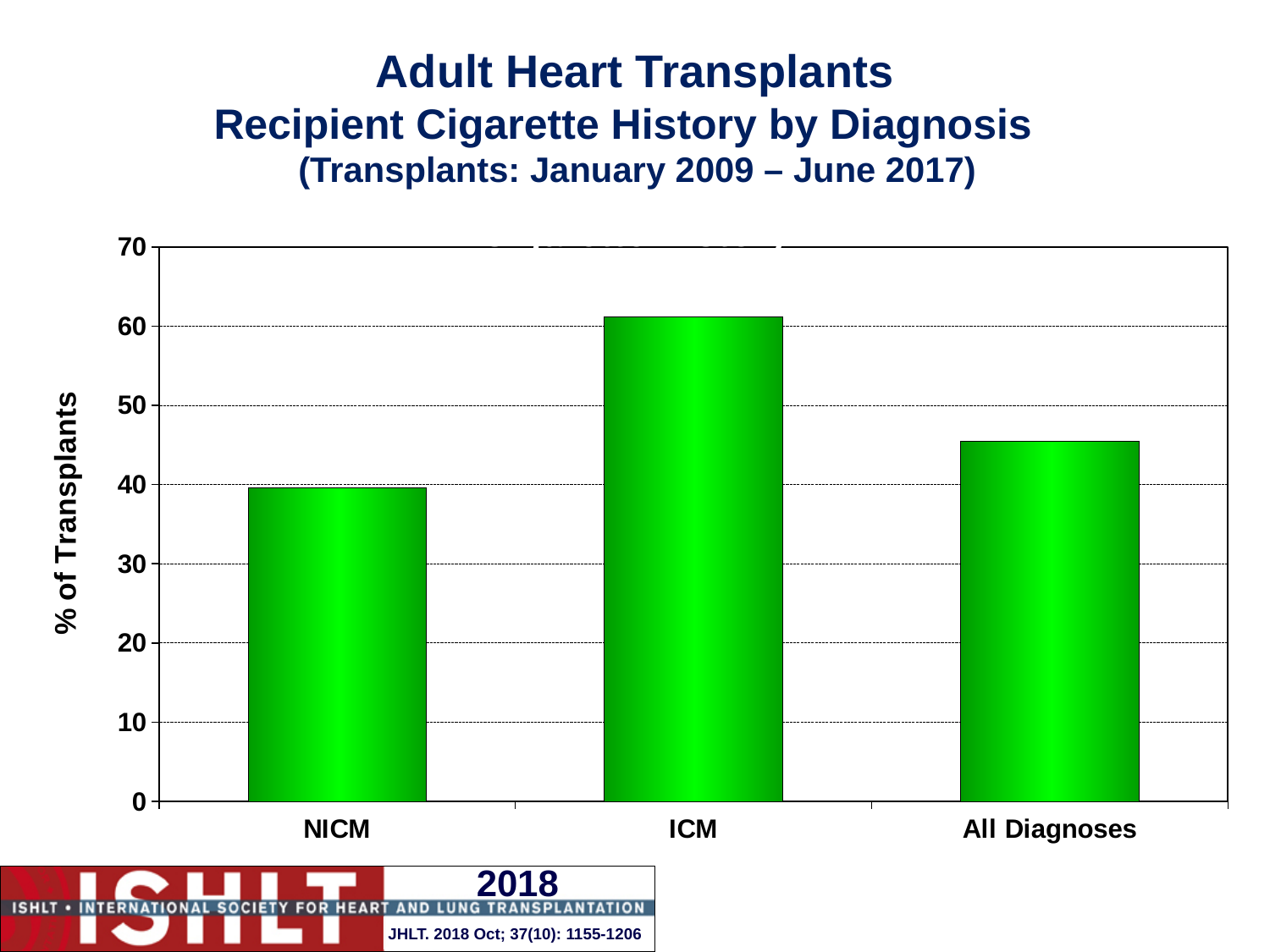
How many diagnosis categories are plotted on the chart? 3 Is the value for ICM greater or less than 50? greater Is the value for NICM greater or less than 50? less What is the label of the y-axis? % of Transplants Which diagnosis category has the highest percentage of transplants with a cigarette history? ICM Which has a higher percentage of transplants: NICM or ICM? ICM Which has a higher percentage of transplants: All Diagnoses or NICM? All Diagnoses Is the value for All Diagnoses greater or less than 40? greater What type of chart is shown on the slide? bar chart What time period of transplants does the chart cover, according to the title? January 2009 – June 2017 Which diagnosis category has the lowest percentage of transplants with a cigarette history? NICM